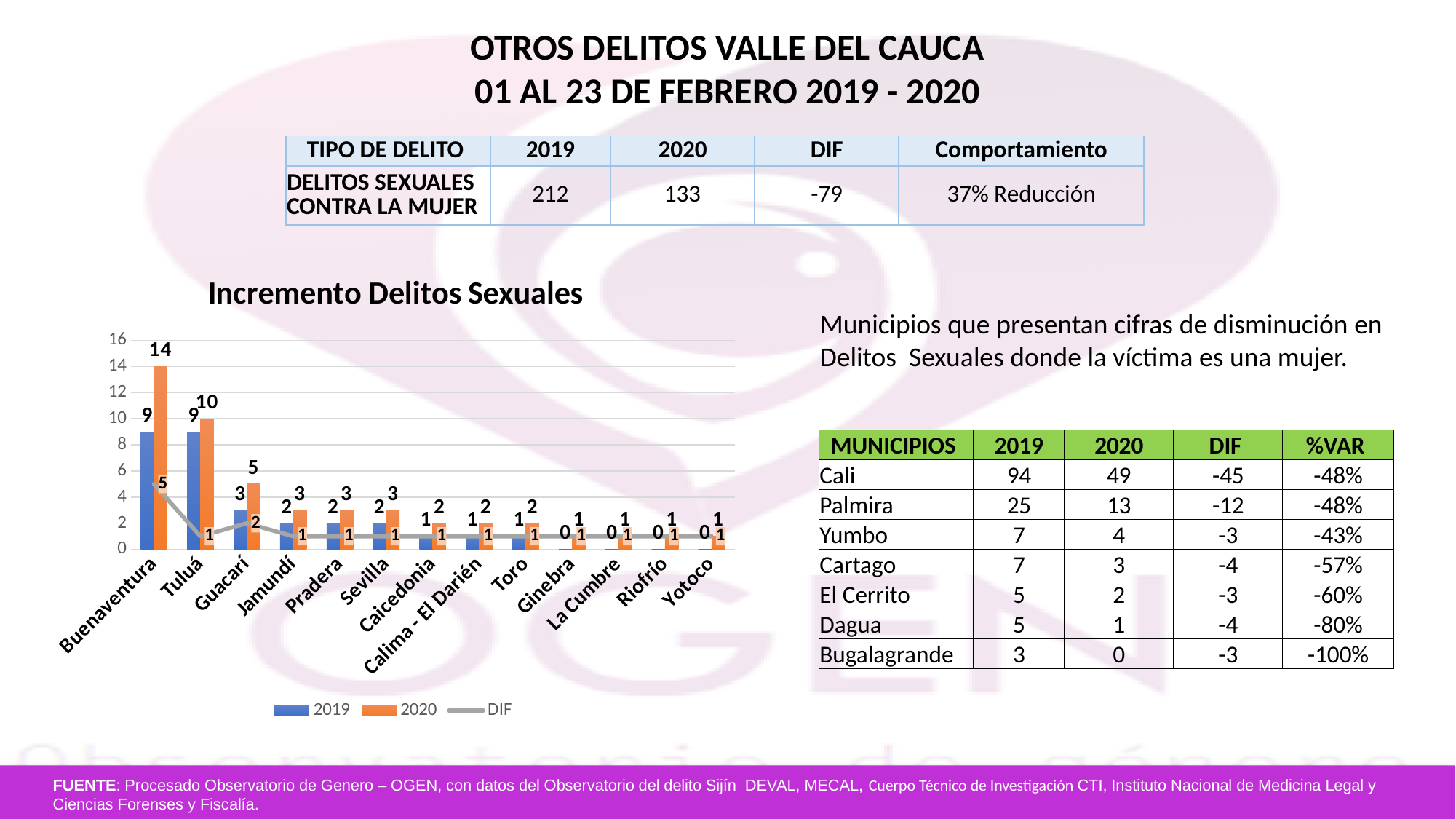
Is the 2020 value for Buenaventura greater or less than 12? greater How many municipalities are shown on the x axis of the chart? 13 How many series does the chart legend list? 3 What is the DIF value for Buenaventura in the chart? 5 What kind of chart is used for the 2019 and 2020 series? Bar chart What is the difference between the 2020 and 2019 values for Tuluá in the chart? 1 Do the 2020 values generally rise or fall from Buenaventura to Yotoco along the x axis? Fall Which municipality has the highest 2020 value in the chart? Buenaventura What is the title of the chart? Incremento Delitos Sexuales Which is larger in the chart: the 2020 value for Guacarí or the 2020 value for Jamundí? Guacarí What is the 2019 value for Guacarí in the chart? 3 What is the 2020 value for Buenaventura in the chart? 14